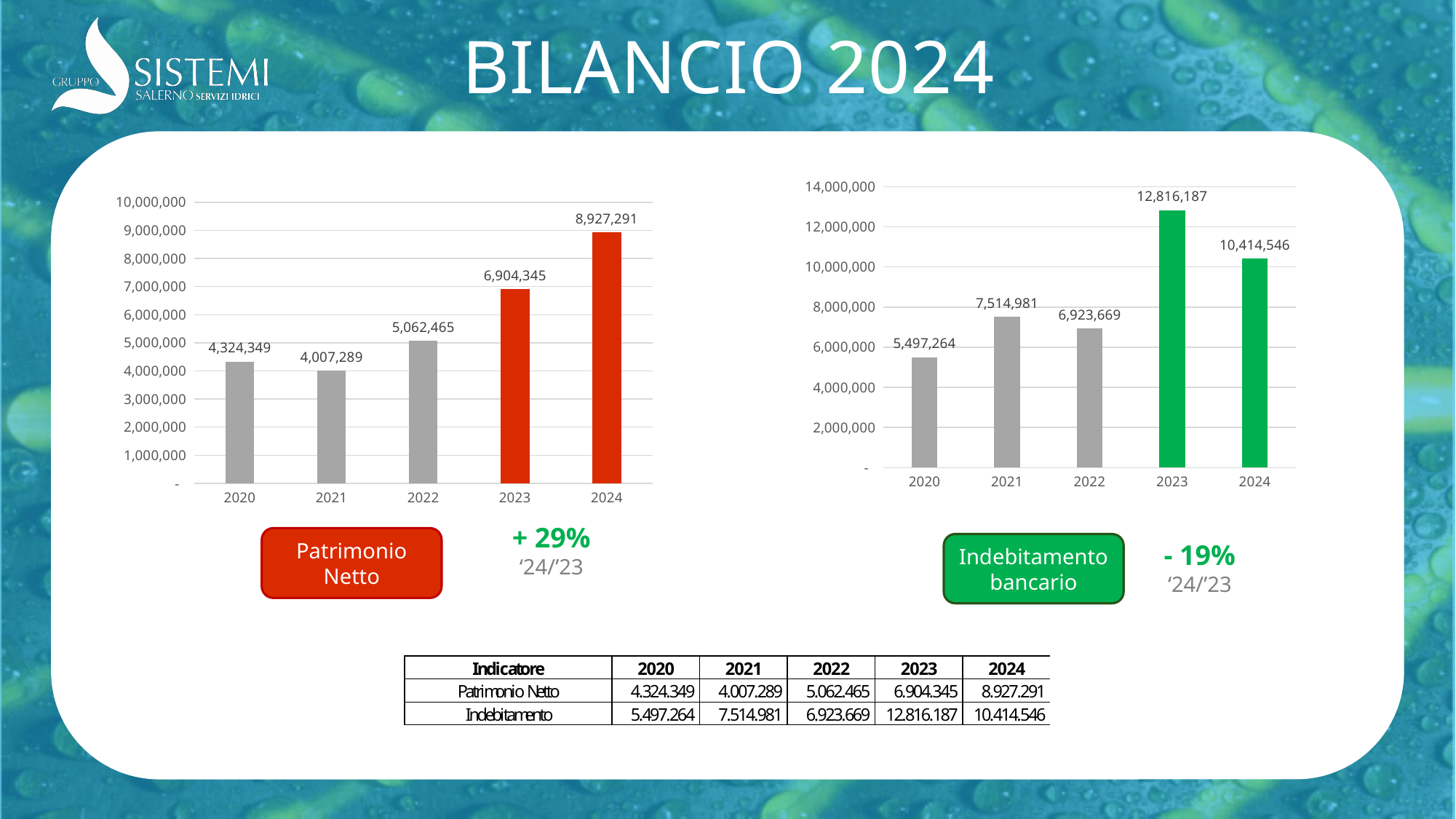
In the Indebitamento bancario chart on the right, which year has the highest value? 2023 In the Patrimonio Netto chart on the left, which year has the lowest value? 2021 In the Indebitamento bancario chart on the right, which is larger: the value for 2021 or the value for 2022? 2021 In the Patrimonio Netto chart on the left, do the values rise or fall from 2021 to 2024? rise In the Indebitamento bancario chart on the right, by how much did the value fall from 2023 to 2024? 2,401,641 In the Patrimonio Netto chart on the left, what is the value for 2024? 8,927,291 In the Patrimonio Netto chart on the left, what is the difference between the 2024 and 2023 values? 2,022,946 In the Indebitamento bancario chart on the right, what colour are the bars for 2023 and 2024? green How many years are shown on the x axis of the Patrimonio Netto chart on the left? 5 In the Indebitamento bancario chart on the right, what is the value for 2023? 12,816,187 What kind of chart is the Indebitamento bancario chart on the right? bar chart In the Patrimonio Netto chart on the left, is the value for 2022 greater or less than 5,000,000? greater